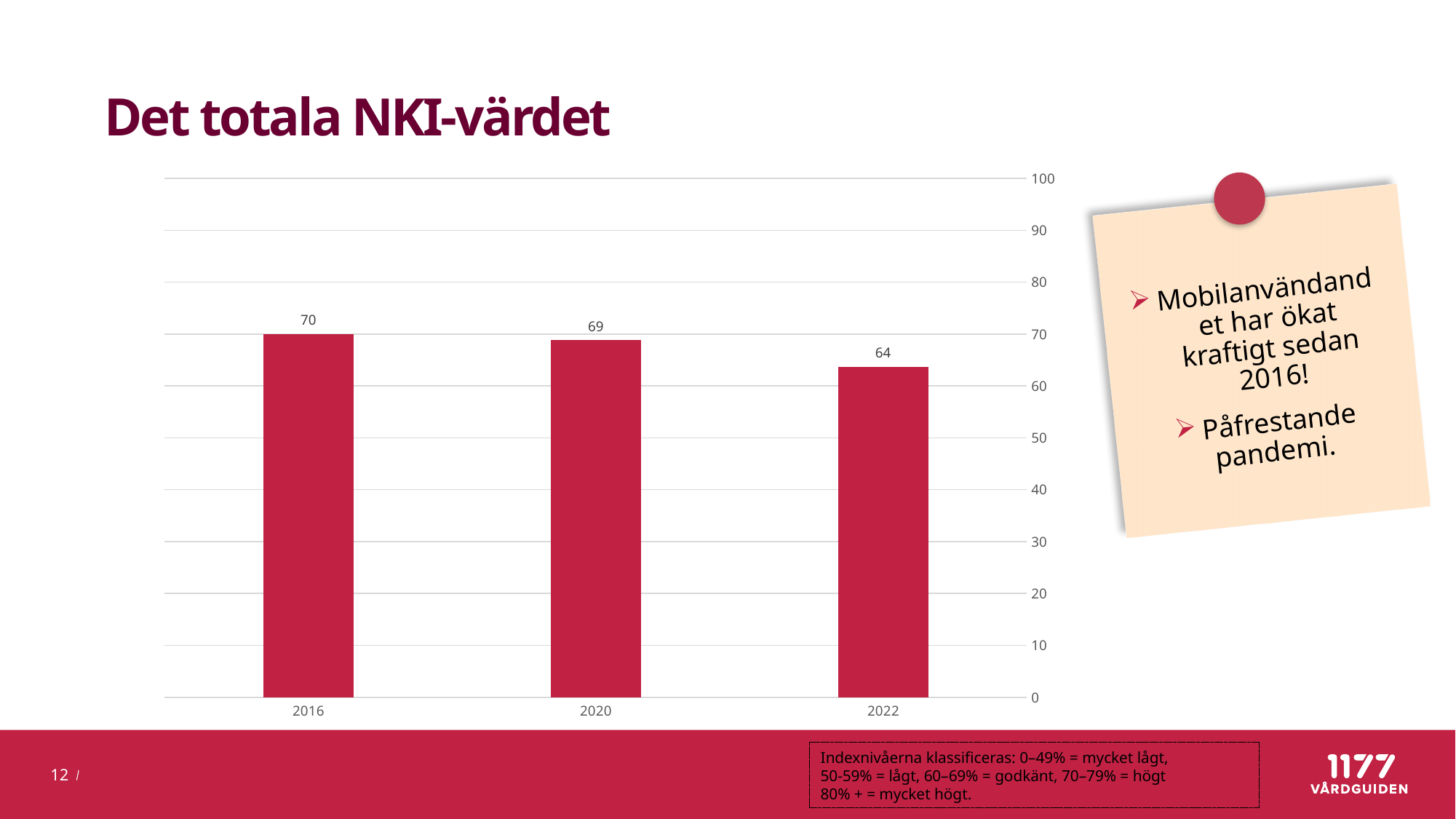
What is the NKI value for 2016? 70 Which is larger, the value for 2020 or the value for 2022? 2020 Which year has the lowest NKI value? 2022 What is the difference between the NKI values for 2016 and 2022? 6 How many years are shown on the chart? 3 Is the value for 2022 greater or less than 60? greater What is the NKI value for 2020? 69 What is the NKI value for 2022? 64 Which year has the highest NKI value? 2016 Do the values rise or fall from 2016 to 2022? fall What kind of chart is shown on the slide? bar chart What is the difference between the NKI values for 2020 and 2022? 5